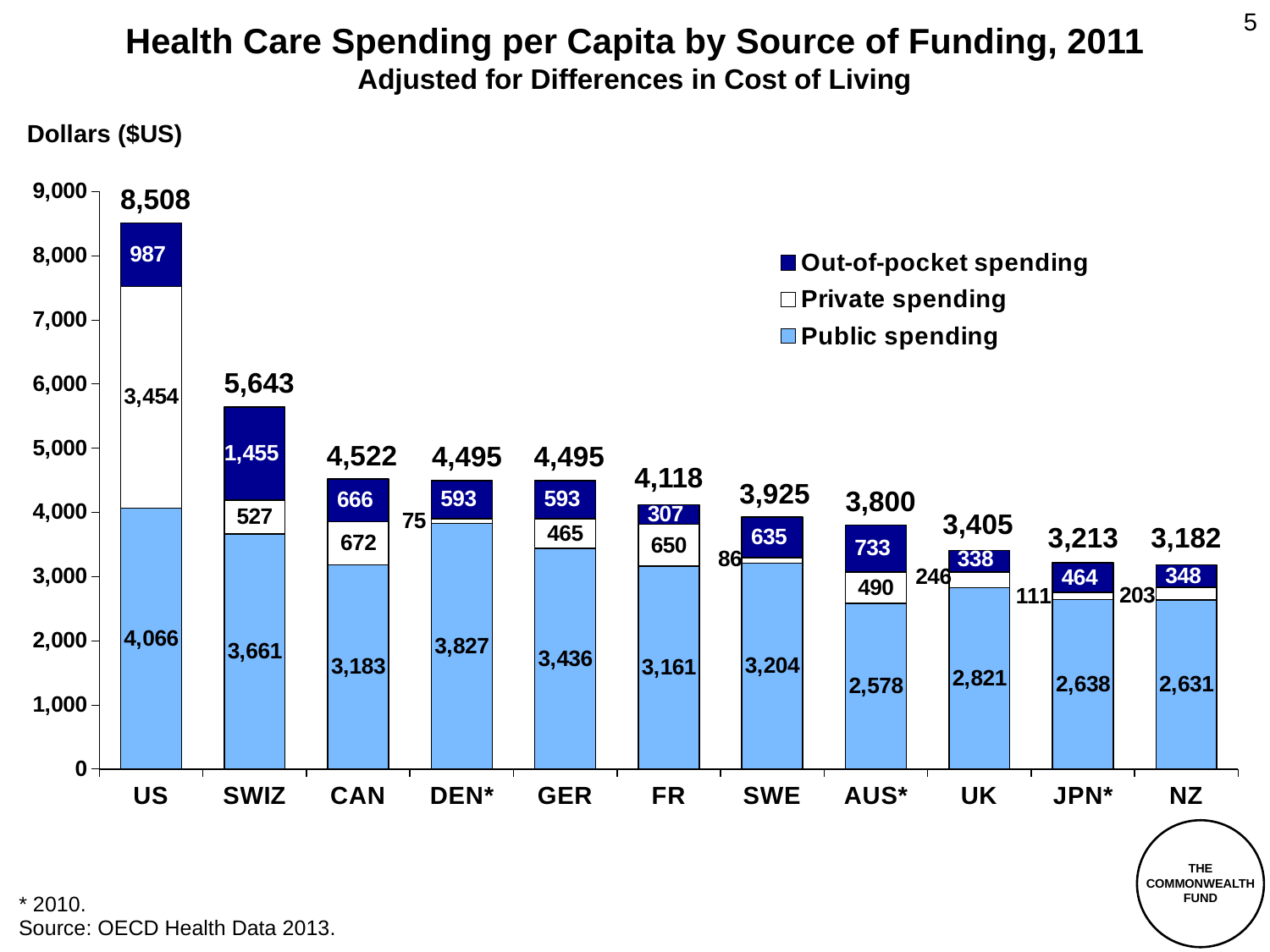
How many countries are shown on the x axis? 11 What is the private spending value for DEN*? 75 What is the out-of-pocket spending value for SWIZ? 1,455 What is the total of the stacked bar for AUS*? 3,800 What is the difference between the total spending for the US and SWIZ? 2,865 What is the public spending value for the US? 4,066 Is the total spending for FR greater or less than 4,000? greater How many series does the legend list? 3 Which country has the lowest total health care spending per capita? NZ Which country has the highest total health care spending per capita? US Which has a larger public spending value, CAN or GER? GER What kind of chart is shown on the slide? Stacked bar chart